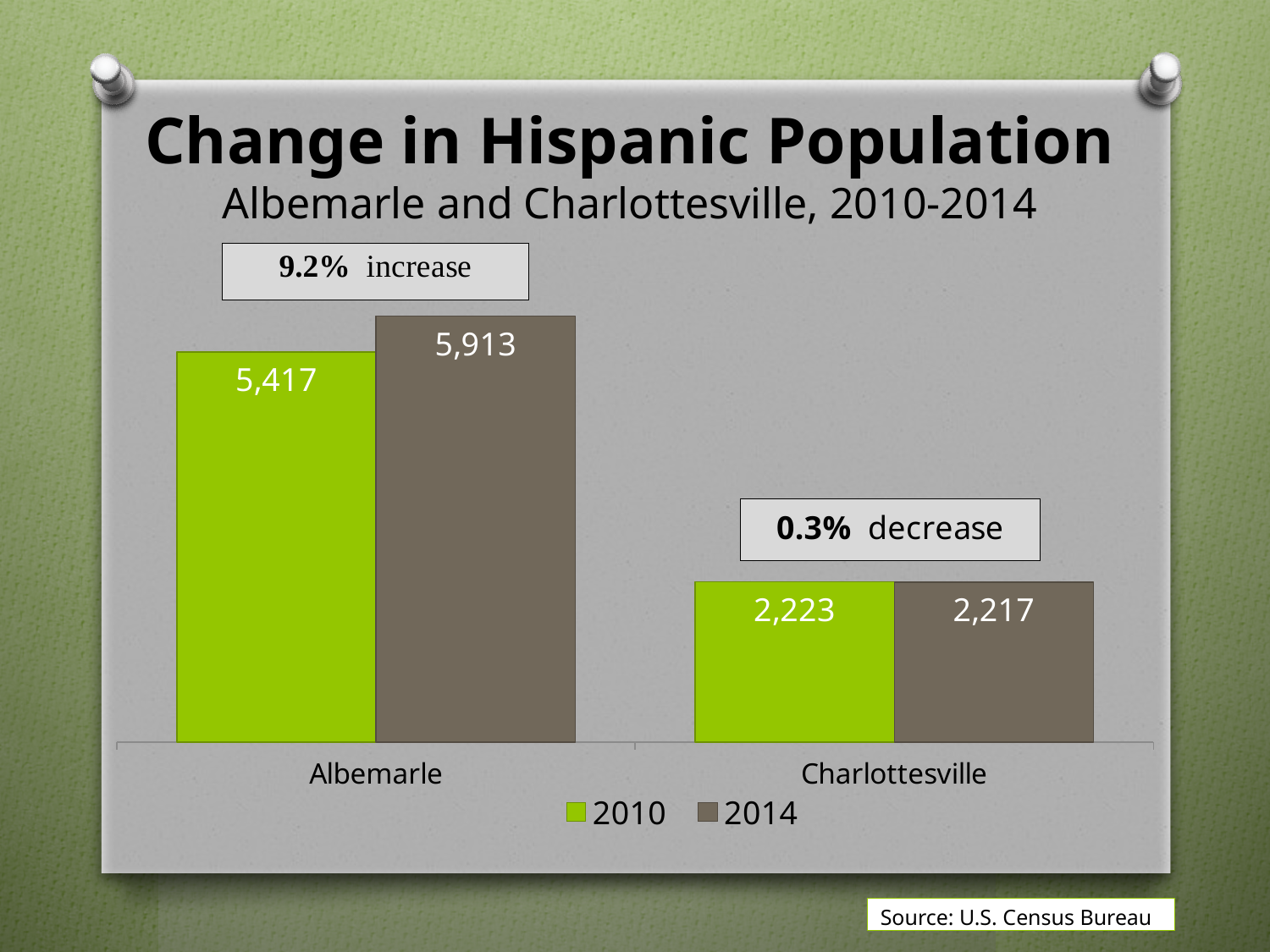
What percentage change is labelled for Charlottesville? 0.3% decrease How many series does the legend list? 2 Which bar shows the highest value on the chart? Albemarle, 2014 What was the Hispanic population of Albemarle in 2014? 5,913 What was the Hispanic population of Albemarle in 2010? 5,417 By how much did Albemarle's Hispanic population grow from 2010 to 2014? 496 What kind of chart is shown on the slide? Bar chart What was the Hispanic population of Charlottesville in 2010? 2,223 Which is larger: Albemarle's 2010 value or Charlottesville's 2014 value? Albemarle's 2010 value What was the Hispanic population of Charlottesville in 2014? 2,217 What is the difference between Charlottesville's 2010 and 2014 values? 6 How many localities are shown on the x axis? 2